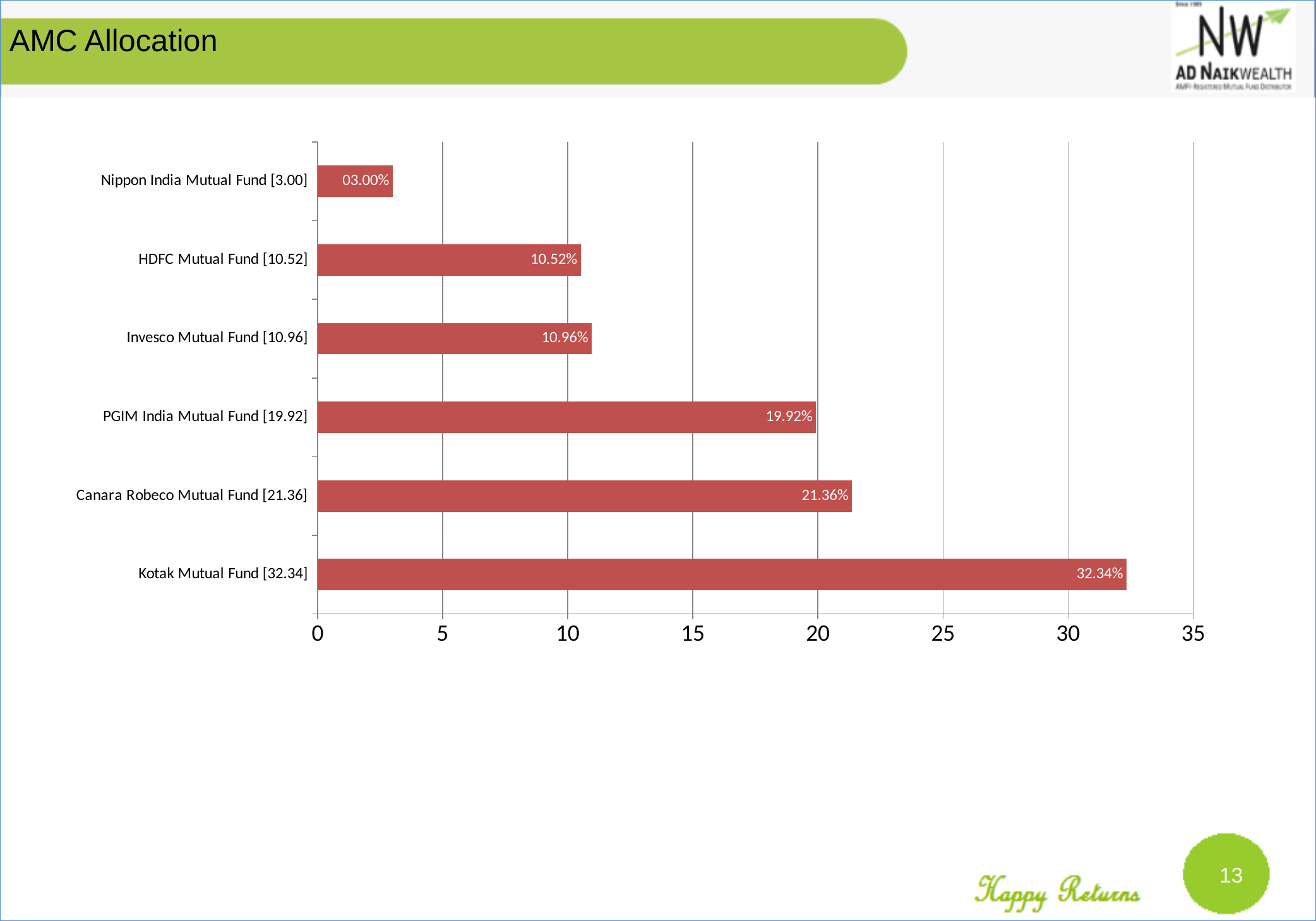
What kind of chart is shown on the slide? bar chart How many funds are shown in the chart? 6 What is the difference between the values for Invesco Mutual Fund and HDFC Mutual Fund? 0.44% What is the value for PGIM India Mutual Fund? 19.92% Which fund has the lowest allocation? Nippon India Mutual Fund What is the title of the slide? AMC Allocation Which fund has the highest allocation? Kotak Mutual Fund What is the difference between the values for Kotak Mutual Fund and Canara Robeco Mutual Fund? 10.98% What is the value for Kotak Mutual Fund? 32.34% What is the value for HDFC Mutual Fund? 10.52% Which is larger, the value for Canara Robeco Mutual Fund or PGIM India Mutual Fund? Canara Robeco Mutual Fund Is the value for Canara Robeco Mutual Fund greater or less than 20? greater